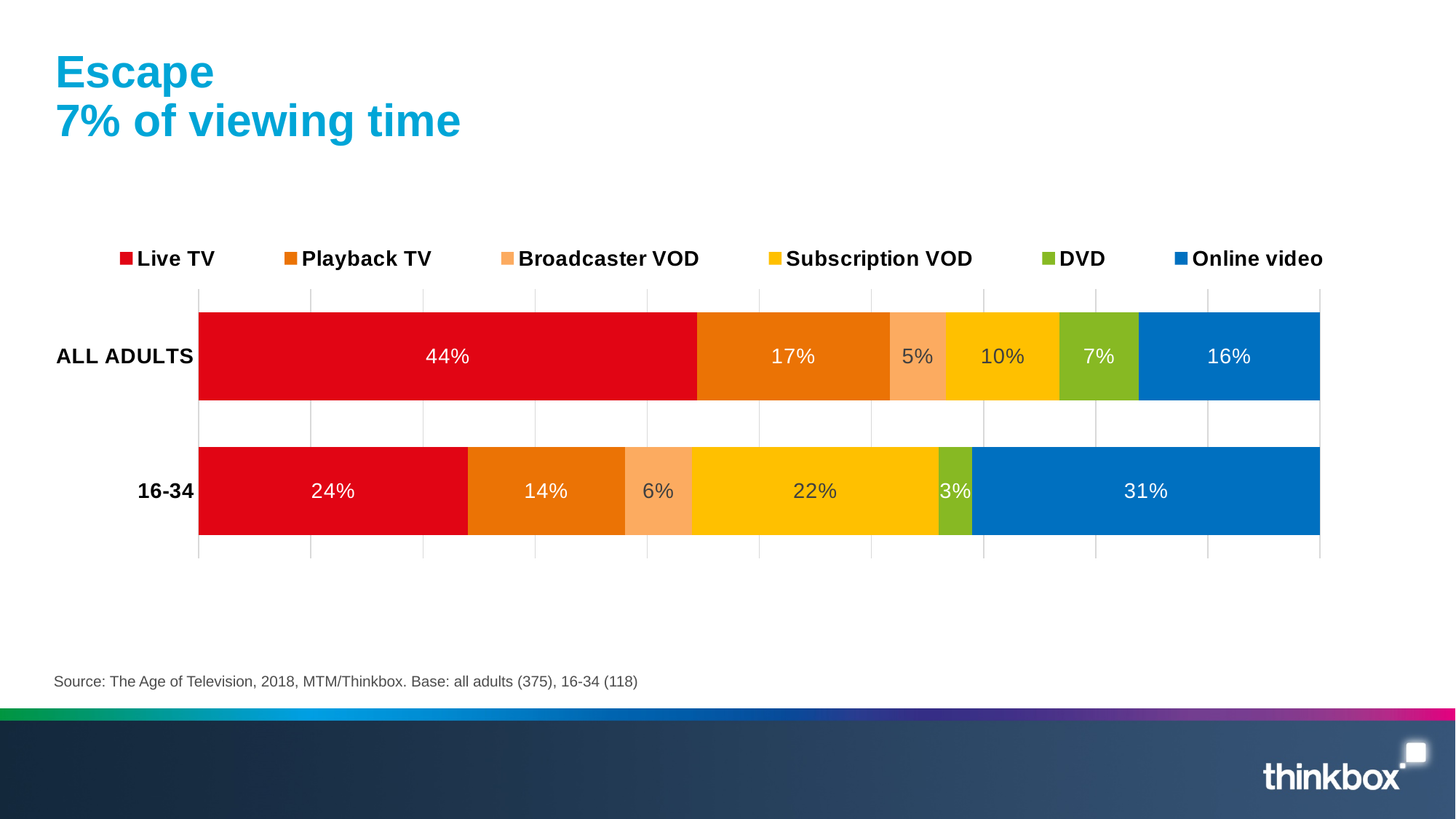
What is the difference between the Live TV share for ALL ADULTS and for 16-34? 20% Which is larger for the 16-34 group: Online video or Live TV? Online video What kind of chart is shown on the slide? Stacked bar chart How many series does the legend list? 6 Which series has the largest share for ALL ADULTS? Live TV What is the total of the stacked bar for the 16-34 group? 100% What share of viewing time is Online video for the 16-34 group? 31% What is the DVD value for ALL ADULTS? 7% What share of viewing time is Live TV for ALL ADULTS? 44% How many categories (bars) are shown on the chart? 2 What is the Subscription VOD value for the 16-34 group? 22% Which series has the smallest share for the 16-34 group? DVD